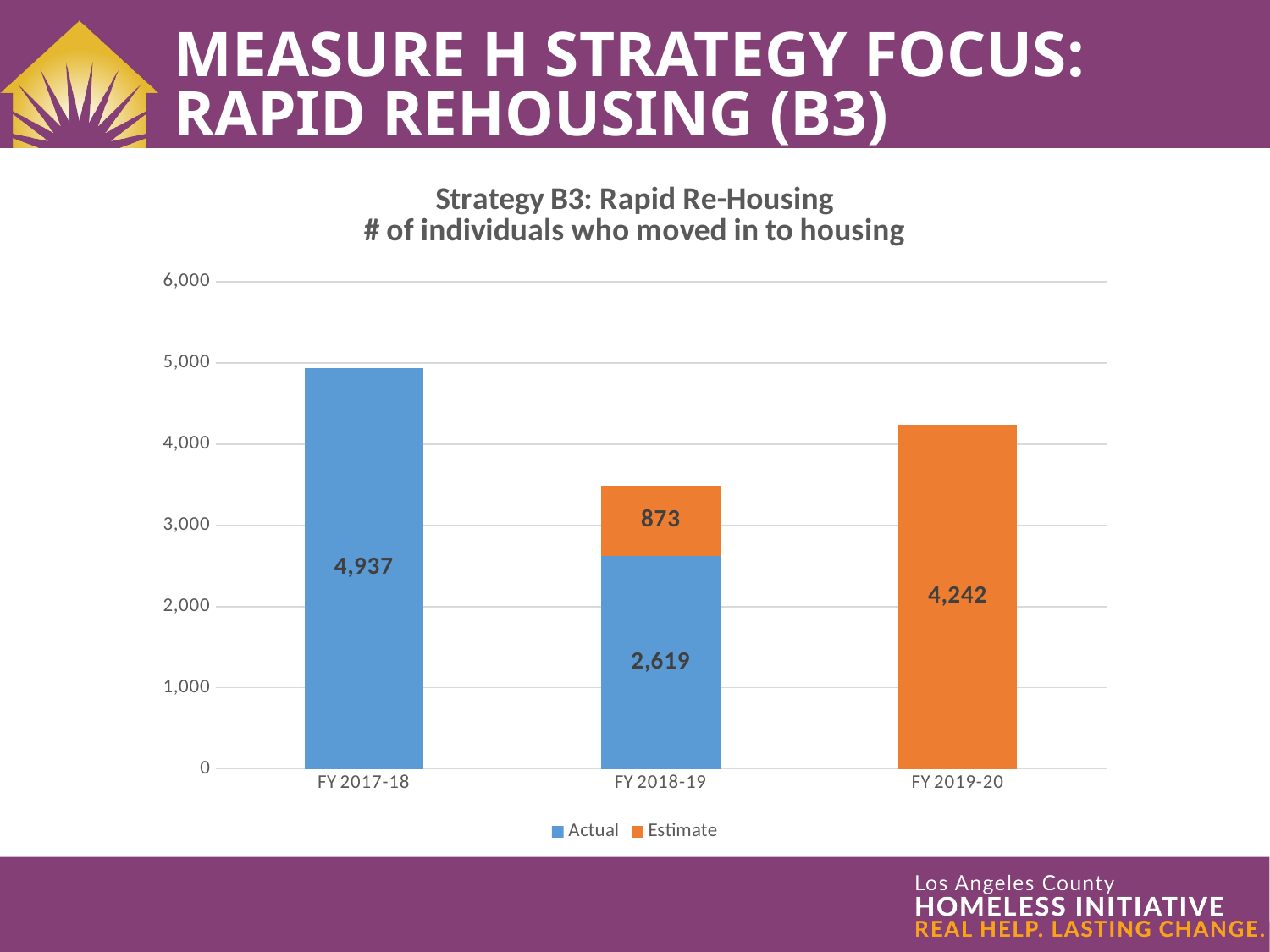
What is the difference between the Actual value for FY 2017-18 and the Actual value for FY 2018-19? 2,318 How many fiscal years are shown on the x axis? 3 What kind of chart is shown on the slide? Stacked bar chart Which is larger: the Actual value for FY 2017-18 or the Estimate value for FY 2019-20? Actual value for FY 2017-18 What is the Actual value for FY 2018-19? 2,619 What is the total of the stacked bar for FY 2018-19? 3,492 Which fiscal year has the tallest bar? FY 2017-18 How many series does the legend list? 2 What is the Estimate value for FY 2019-20? 4,242 What is the Actual value for FY 2017-18? 4,937 Which fiscal year has the shortest bar? FY 2018-19 What is the Estimate value for FY 2018-19? 873